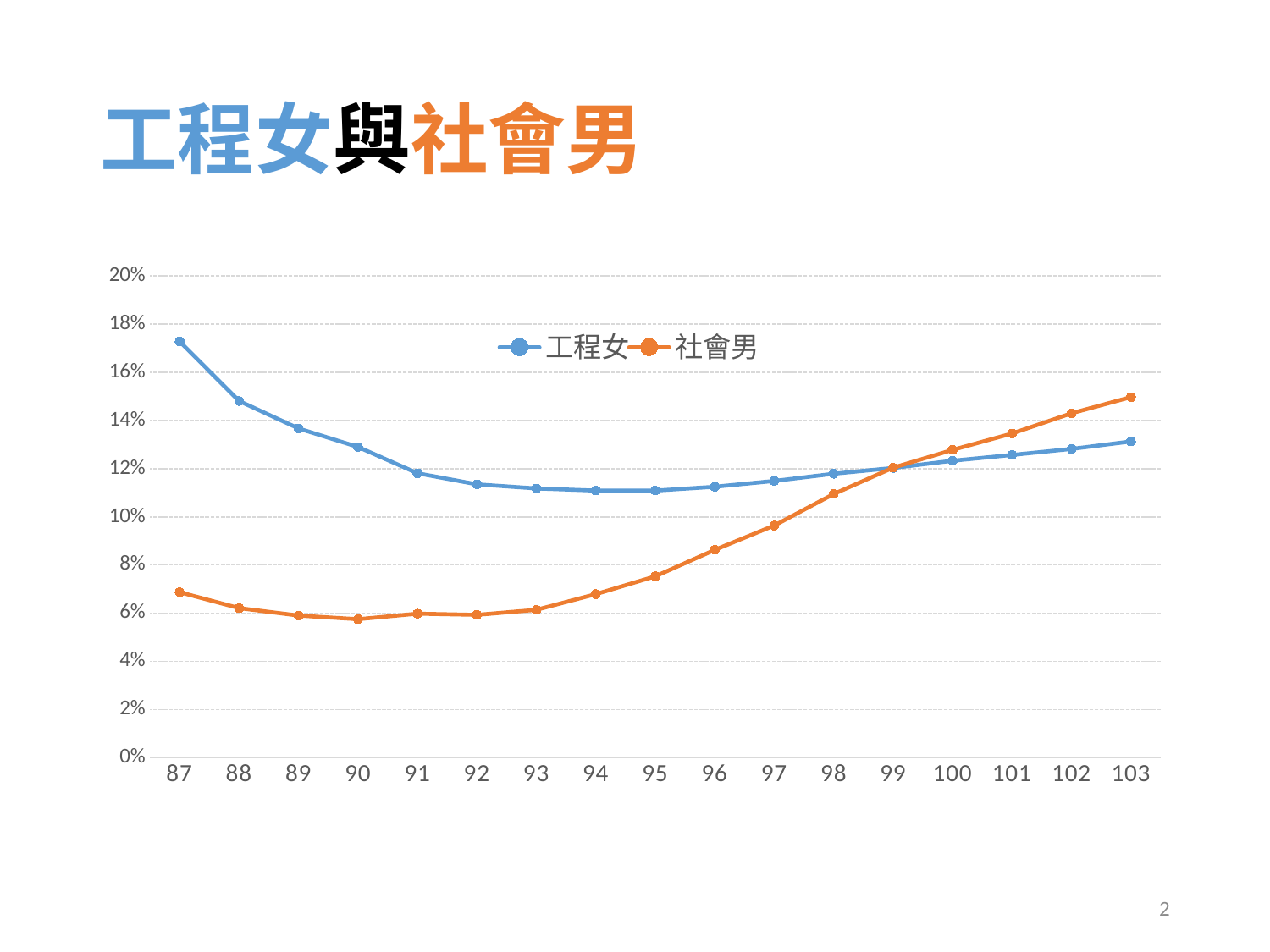
At 95, which series has the larger value, 工程女 or 社會男? 工程女 How many points are plotted along the x axis for each series? 17 Is the value for 工程女 at 87 greater or less than 16%? greater What kind of chart is shown on the slide? line chart How many series does the legend list? 2 Is the value for 社會男 at 103 greater or less than 14%? greater At which x-axis value is the 工程女 series highest? 87 At which x-axis value is the 社會男 series highest? 103 Does the 工程女 series rise or fall from 87 to 94? fall Is the value for 社會男 at 97 greater or less than 10%? less Does the 社會男 series rise or fall from 93 to 103? rise At 103, which series has the larger value, 工程女 or 社會男? 社會男